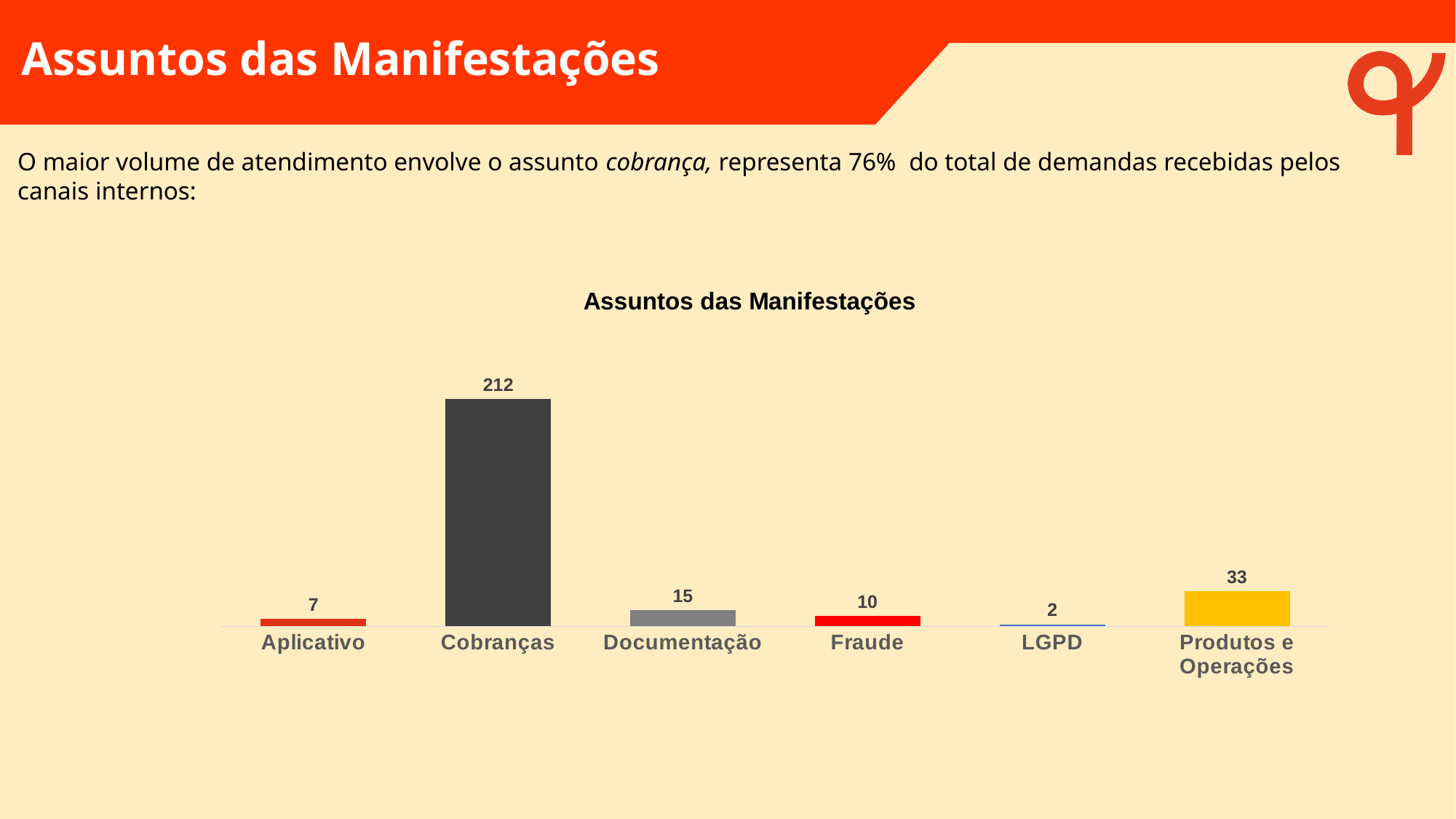
How many categories are shown on the x axis? 6 What is the value for LGPD? 2 What is the value for Documentação? 15 What is the difference between the values for Cobranças and Produtos e Operações? 179 What is the value for Produtos e Operações? 33 What kind of chart is shown on the slide? Bar chart What is the value for Cobranças? 212 Which category has the highest value? Cobranças Which is larger, the value for Aplicativo or the value for Fraude? Fraude Which category has the lowest value? LGPD What is the title of the chart? Assuntos das Manifestações What is the difference between the values for Documentação and Fraude? 5